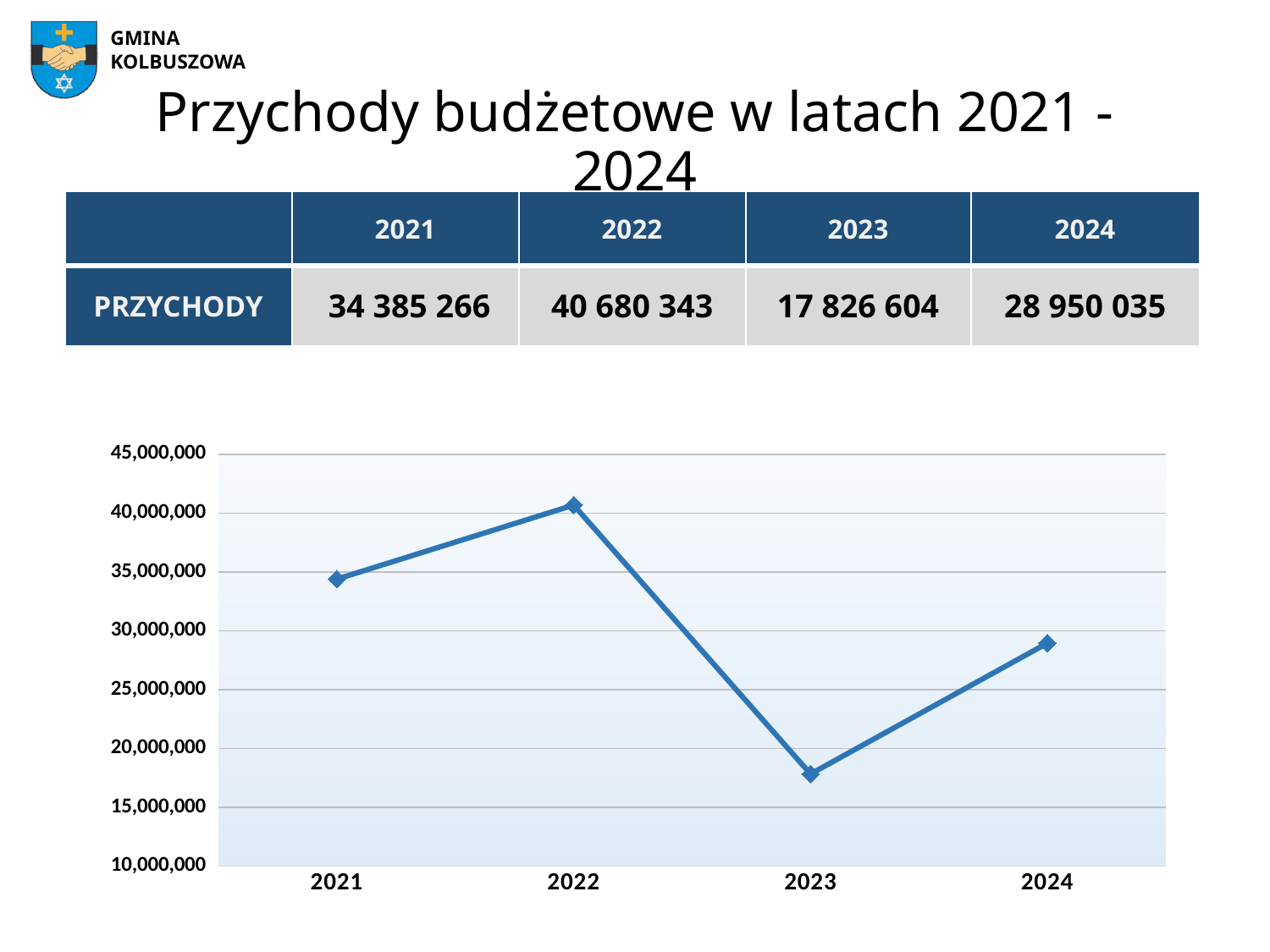
What is the value of PRZYCHODY for 2024? 28 950 035 What is the value of PRZYCHODY for 2022? 40 680 343 What is the difference between the PRZYCHODY values for 2024 and 2023? 11 123 431 How many years are plotted on the x axis of the chart? 4 What is the value of PRZYCHODY for 2023? 17 826 604 What is the difference between the PRZYCHODY values for 2022 and 2021? 6 295 077 Which year has the highest value of PRZYCHODY? 2022 Which year has a larger value of PRZYCHODY, 2021 or 2024? 2021 Does the value rise or fall from 2022 to 2023? fall Which year has the lowest value of PRZYCHODY? 2023 Is the value for 2023 greater or less than 20,000,000? less What type of chart is shown on the slide? line chart